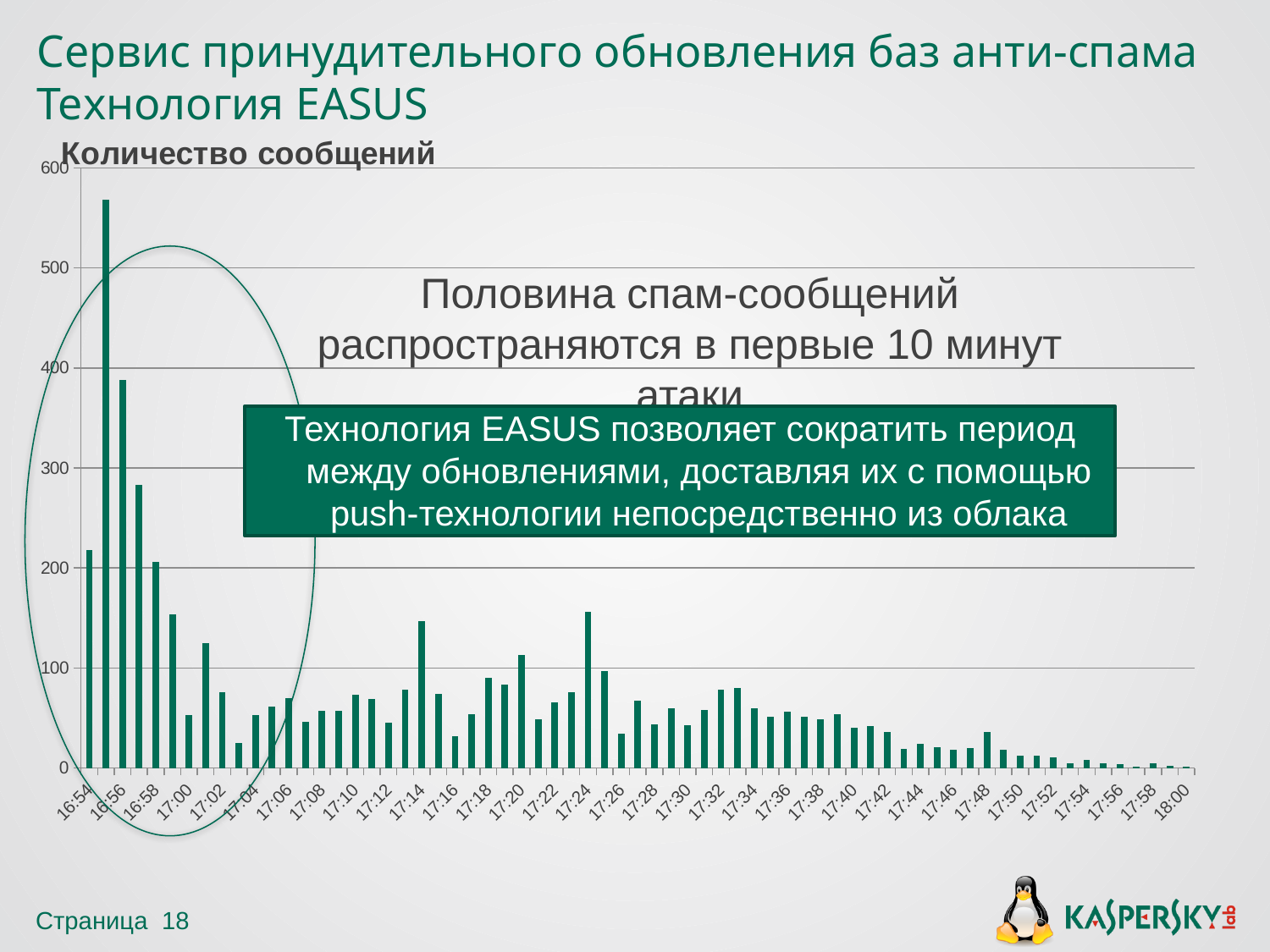
Is the value for 16:56 greater or less than 300? greater What is the highest value shown on the vertical axis? 600 Which has the larger value, 16:56 or 17:00? 16:56 Is the value for 18:00 greater or less than 100? less Which has the larger value, 17:24 or 17:50? 17:24 What kind of chart is shown on the slide? bar chart Overall, do the values rise or fall from 16:54 to 18:00? fall Is the value for 17:00 greater or less than 100? less What is the title of the chart? Количество сообщений